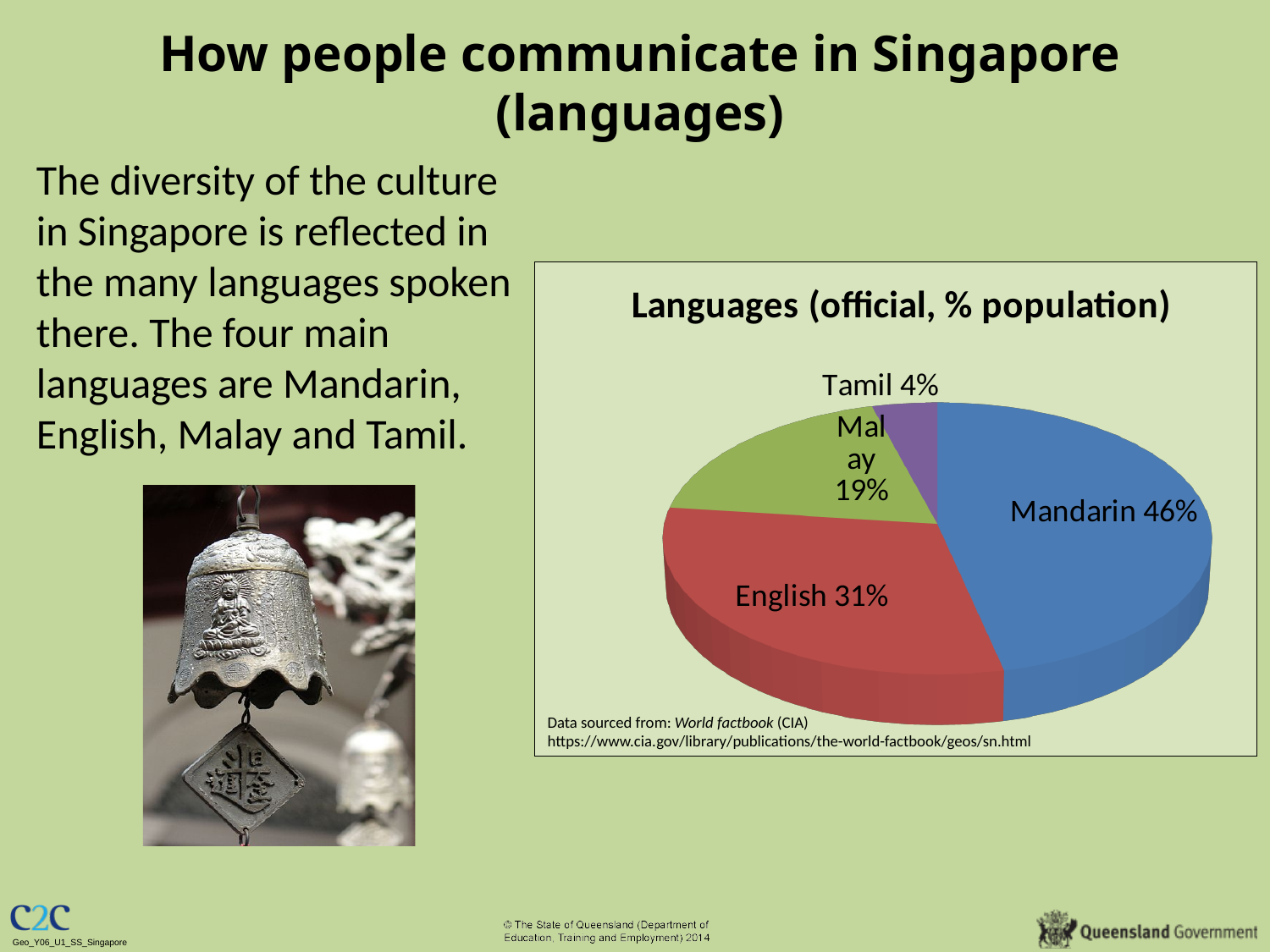
How many languages are shown in the pie chart? 4 What is the difference in percentage points between Mandarin and English in the pie chart? 15 What percentage of the population speaks Malay according to the pie chart? 19% Which language has the largest share in the pie chart? Mandarin What type of chart is shown on the slide? Pie chart Which has a larger share in the pie chart, Malay or English? English What percentage of the population speaks Mandarin according to the pie chart? 46% What percentage of the population speaks Tamil according to the pie chart? 4% What is the title of the chart on the slide? Languages (official, % population) Which language has the smallest share in the pie chart? Tamil What colour is the Mandarin slice in the pie chart? Blue What percentage of the population speaks English according to the pie chart? 31%